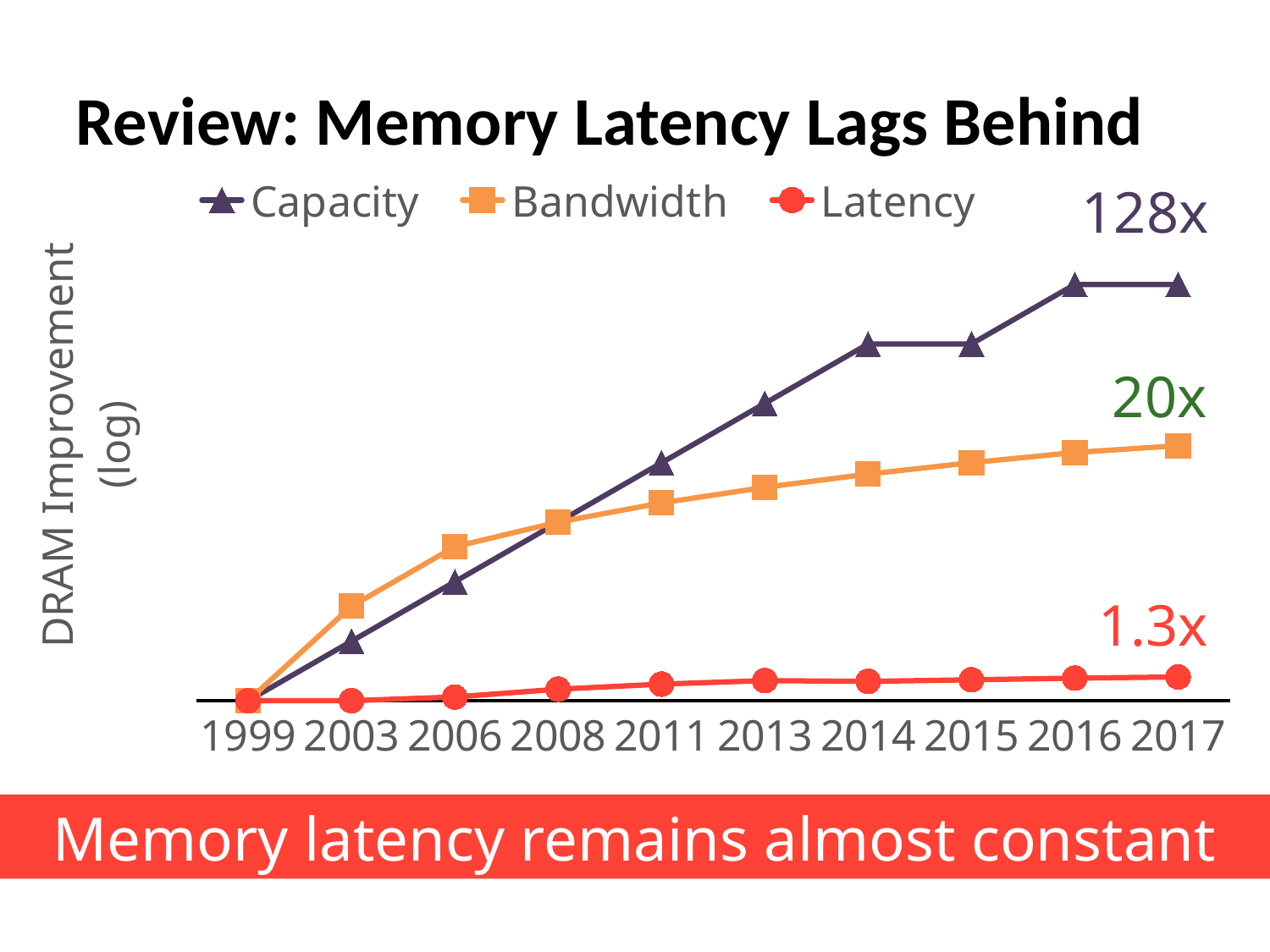
How many series does the legend list? 3 What improvement factor is labelled for Latency at the end of the chart? 1.3x What is the label on the y axis of the chart? DRAM Improvement (log) Which series shows the highest DRAM improvement in 2017? Capacity In 2003, which is higher: Capacity or Bandwidth? Bandwidth What improvement factor is labelled for Bandwidth at the end of the chart? 20x What kind of chart is shown on the slide? line chart How many years are shown along the x axis? 10 Does the Capacity series rise or fall from 1999 to 2017? rise What improvement factor is labelled for Capacity at the end of the chart? 128x In 2017, which is higher: Capacity or Bandwidth? Capacity Which series shows the lowest DRAM improvement in 2017? Latency